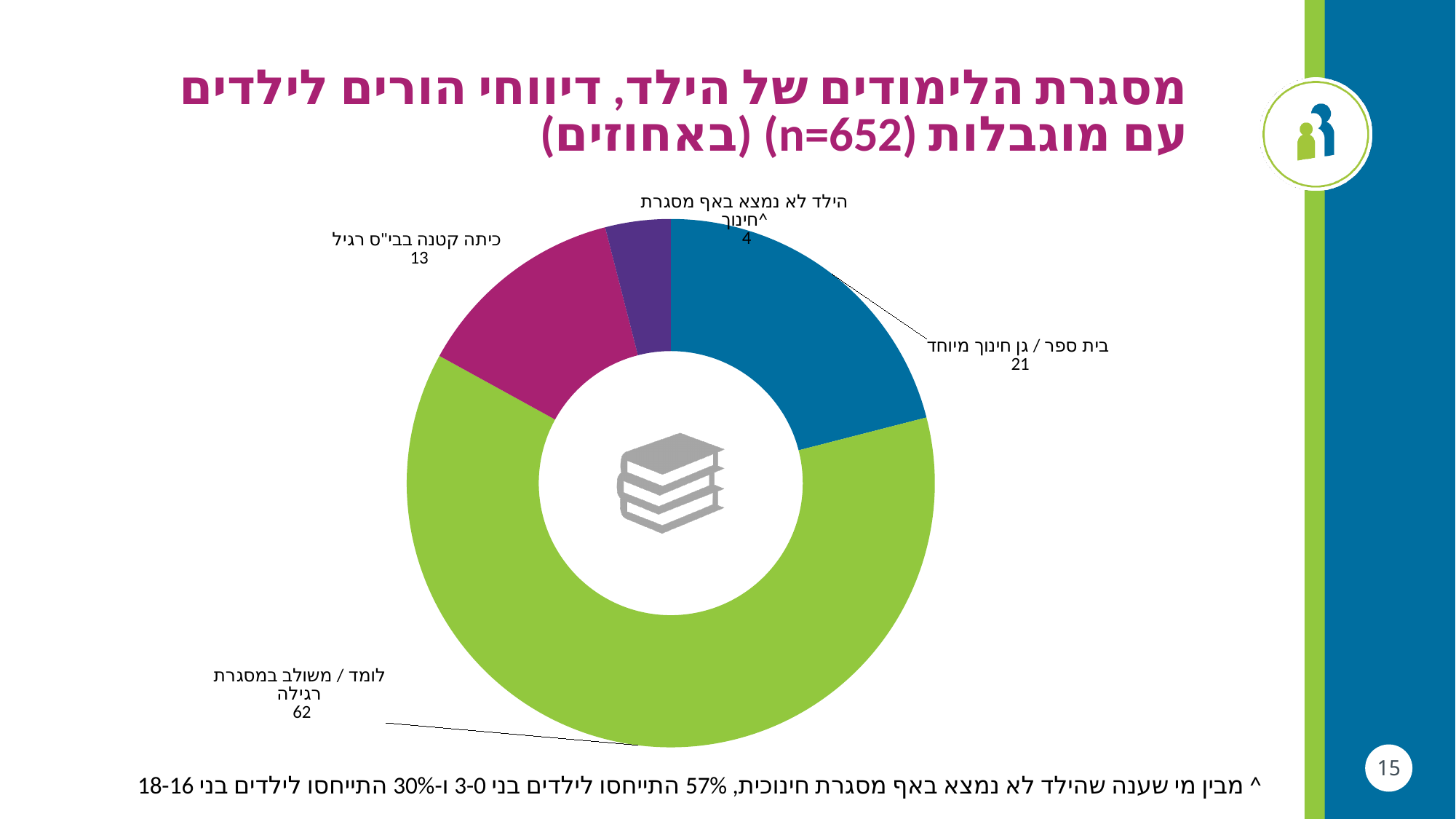
What is the value shown for "בית ספר / גן חינוך מיוחד"? 21 What is the sample size (n) stated in the chart title? 652 Which is larger: the value for "כיתה קטנה בבי"ס רגיל" or the value for "בית ספר / גן חינוך מיוחד"? בית ספר / גן חינוך מיוחד Which category has the smallest slice? הילד לא נמצא באף מסגרת חינוך What colour is the slice for "לומד / משולב במסגרת רגילה"? Green What kind of chart is shown on the slide? Pie chart (donut) Which category has the largest slice? לומד / משולב במסגרת רגילה What is the value shown for "לומד / משולב במסגרת רגילה"? 62 What is the value shown for "כיתה קטנה בבי"ס רגיל"? 13 How many categories are shown in the chart? 4 What is the difference between the values for "לומד / משולב במסגרת רגילה" and "בית ספר / גן חינוך מיוחד"? 41 What is the value shown for "הילד לא נמצא באף מסגרת חינוך"? 4